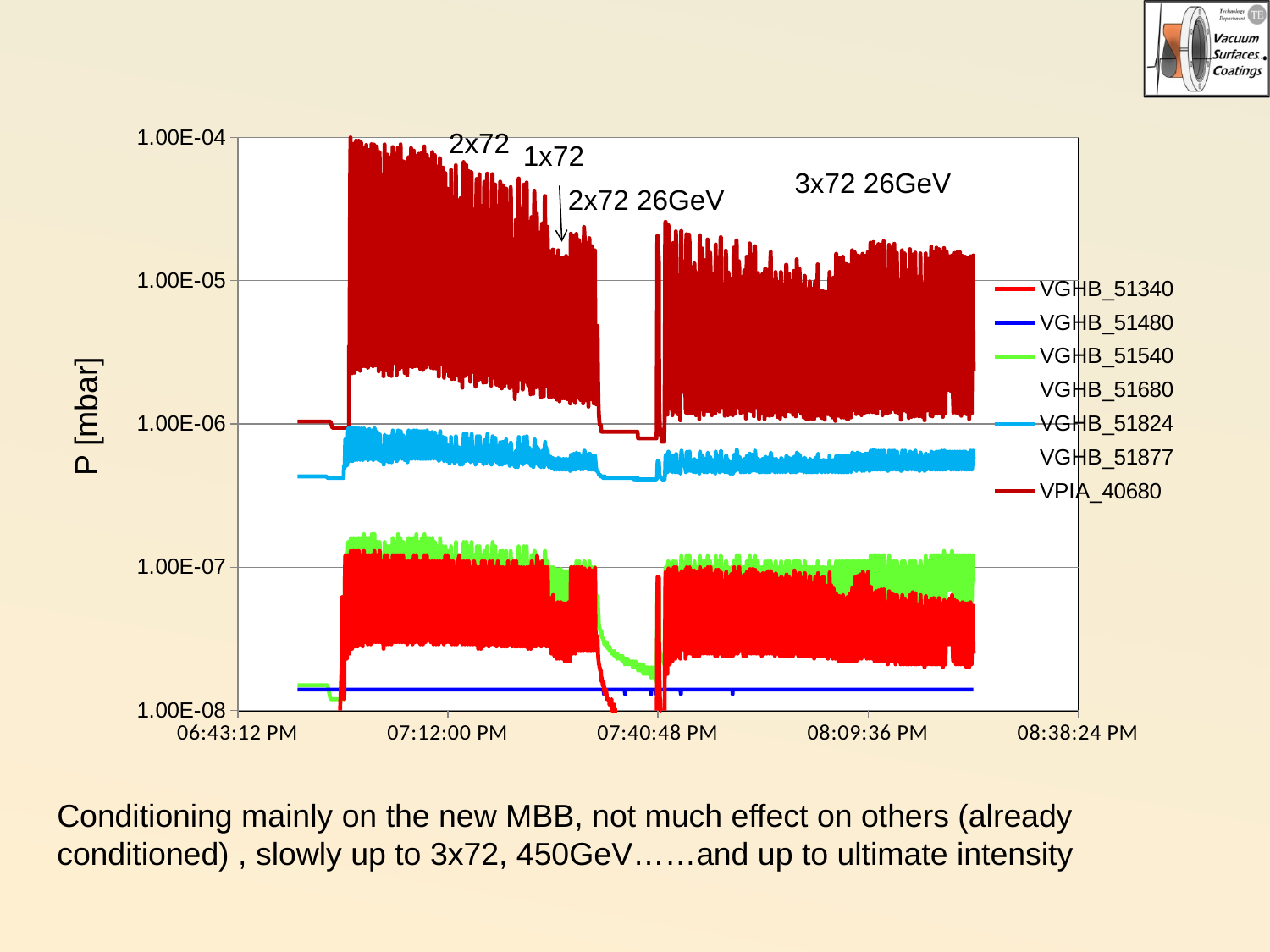
How many time labels are shown on the x-axis? 5 What is the label of the y-axis? P [mbar] Is the value for VGHB_51480 greater or less than 1.00E-07? less Is the value for VGHB_51824 at 08:09:36 PM greater or less than 1.00E-06? less What kind of chart is shown on the slide? line chart Which series has the lowest values across the whole time range? VGHB_51480 How many series does the legend list? 7 Is the value for VGHB_51824 at 07:12:00 PM greater or less than 1.00E-07? greater Which of VGHB_51824 and VGHB_51480 has the larger value at 08:09:36 PM? VGHB_51824 What is the highest value shown on the y-axis? 1.00E-04 What is the first entry in the legend? VGHB_51340